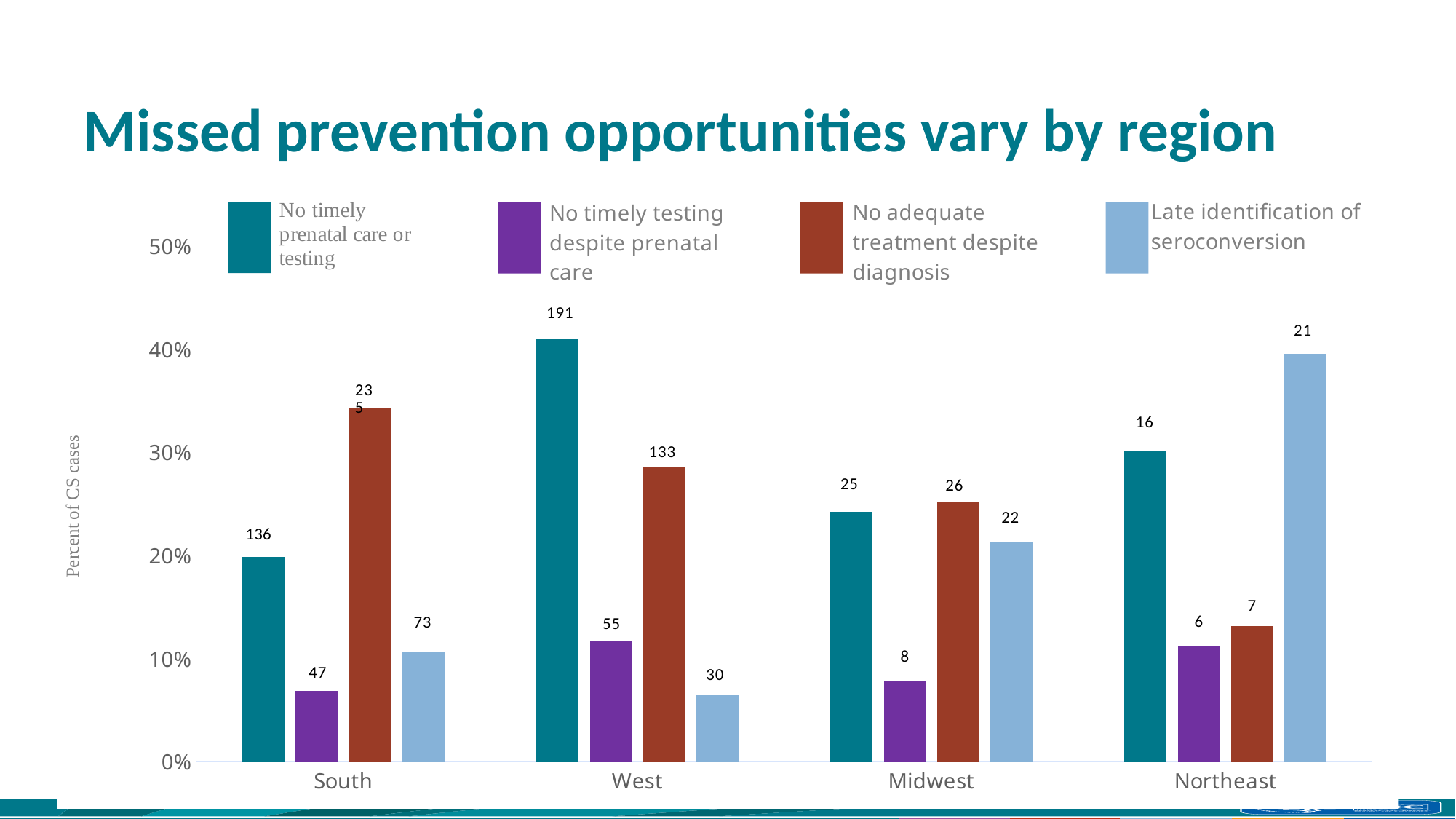
Which series has the shortest bar for the South region? No timely testing despite prenatal care What data label is printed on the 'No timely prenatal care or testing' bar for West? 191 Is the percentage for 'Late identification of seroconversion' in the West greater or less than 10%? less How many series does the chart legend list? 4 What type of chart is shown on the slide? bar chart Which series has the tallest bar for the West region? No timely prenatal care or testing What data label is printed on the 'No timely testing despite prenatal care' bar for Midwest? 8 What data label is printed on the 'No adequate treatment despite diagnosis' bar for West? 133 Which series has the tallest bar for the Northeast region? Late identification of seroconversion What data label is printed on the 'Late identification of seroconversion' bar for Northeast? 21 Is the percentage for 'No timely prenatal care or testing' in the West greater or less than 40%? greater How many regions are shown on the x axis of the chart? 4